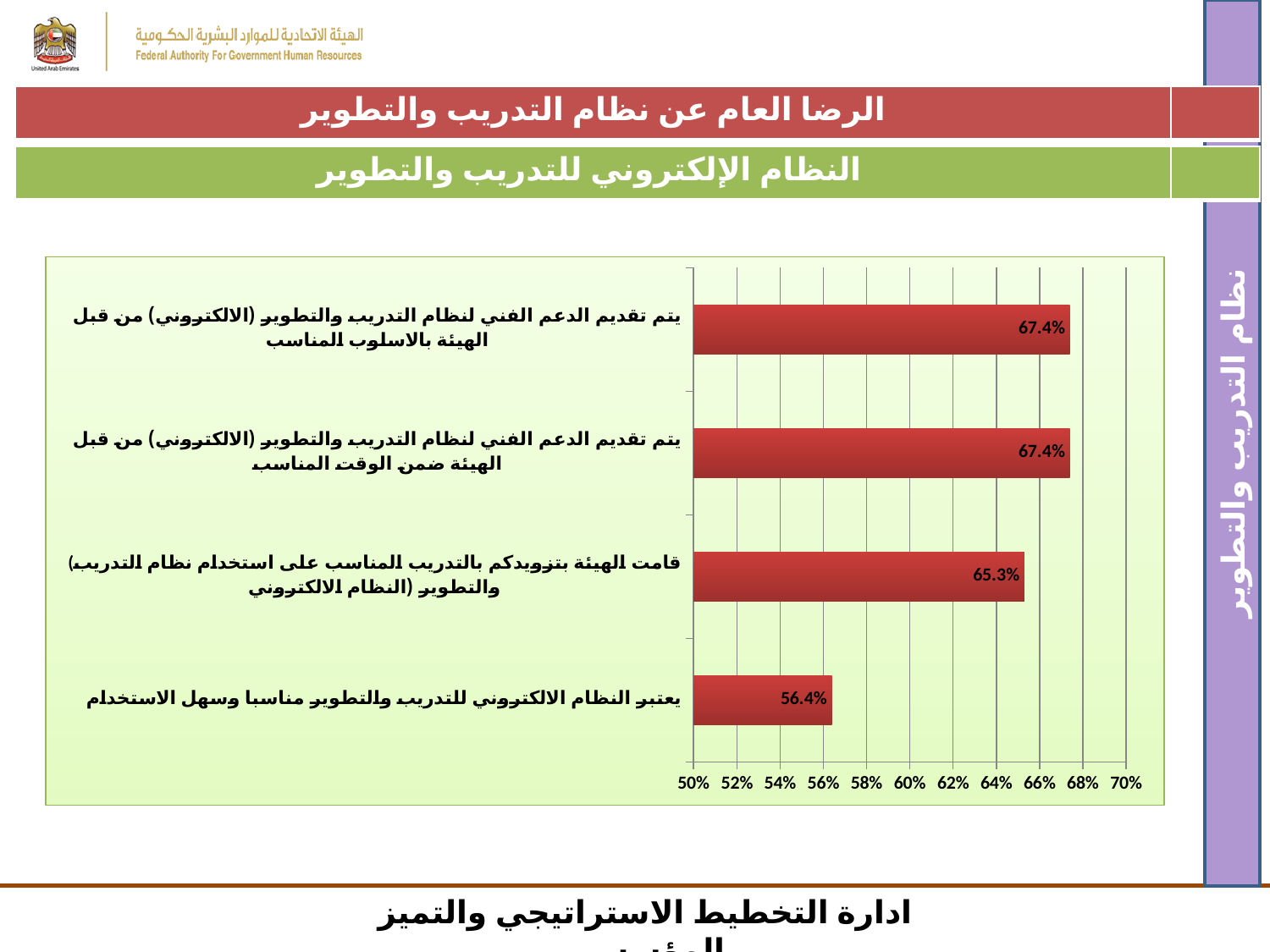
What is the value for "يعتبر النظام الالكتروني للتدريب والتطوير مناسبا وسهل الاستخدام"? 56.4% What is the value for "قامت الهيئة بتزويدكم بالتدريب المناسب على استخدام نظام التدريب والتطوير (النظام الالكتروني)"? 65.3% Which is larger: the value for "قامت الهيئة بتزويدكم بالتدريب المناسب على استخدام نظام التدريب والتطوير (النظام الالكتروني)" or the value for "يعتبر النظام الالكتروني للتدريب والتطوير مناسبا وسهل الاستخدام"? قامت الهيئة بتزويدكم بالتدريب المناسب على استخدام نظام التدريب والتطوير (النظام الالكتروني) Is the value for "يعتبر النظام الالكتروني للتدريب والتطوير مناسبا وسهل الاستخدام" greater or less than 60%? less What is the value for "يتم تقديم الدعم الفني لنظام التدريب والتطوير (الالكتروني) من قبل الهيئة بالاسلوب المناسب"? 67.4% What is the value for "يتم تقديم الدعم الفني لنظام التدريب والتطوير (الالكتروني) من قبل الهيئة ضمن الوقت المناسب"? 67.4% Which category has the lowest value? يعتبر النظام الالكتروني للتدريب والتطوير مناسبا وسهل الاستخدام What kind of chart is shown on the slide? bar chart What is the title shown in the green header above the chart? النظام الإلكتروني للتدريب والتطوير What is the difference between the value for "يتم تقديم الدعم الفني لنظام التدريب والتطوير (الالكتروني) من قبل الهيئة ضمن الوقت المناسب" and the value for "قامت الهيئة بتزويدكم بالتدريب المناسب على استخدام نظام التدريب والتطوير (النظام الالكتروني)"? 2.1% How many categories are shown in the chart? 4 What is the difference between the value for "قامت الهيئة بتزويدكم بالتدريب المناسب على استخدام نظام التدريب والتطوير (النظام الالكتروني)" and the value for "يعتبر النظام الالكتروني للتدريب والتطوير مناسبا وسهل الاستخدام"? 8.9%